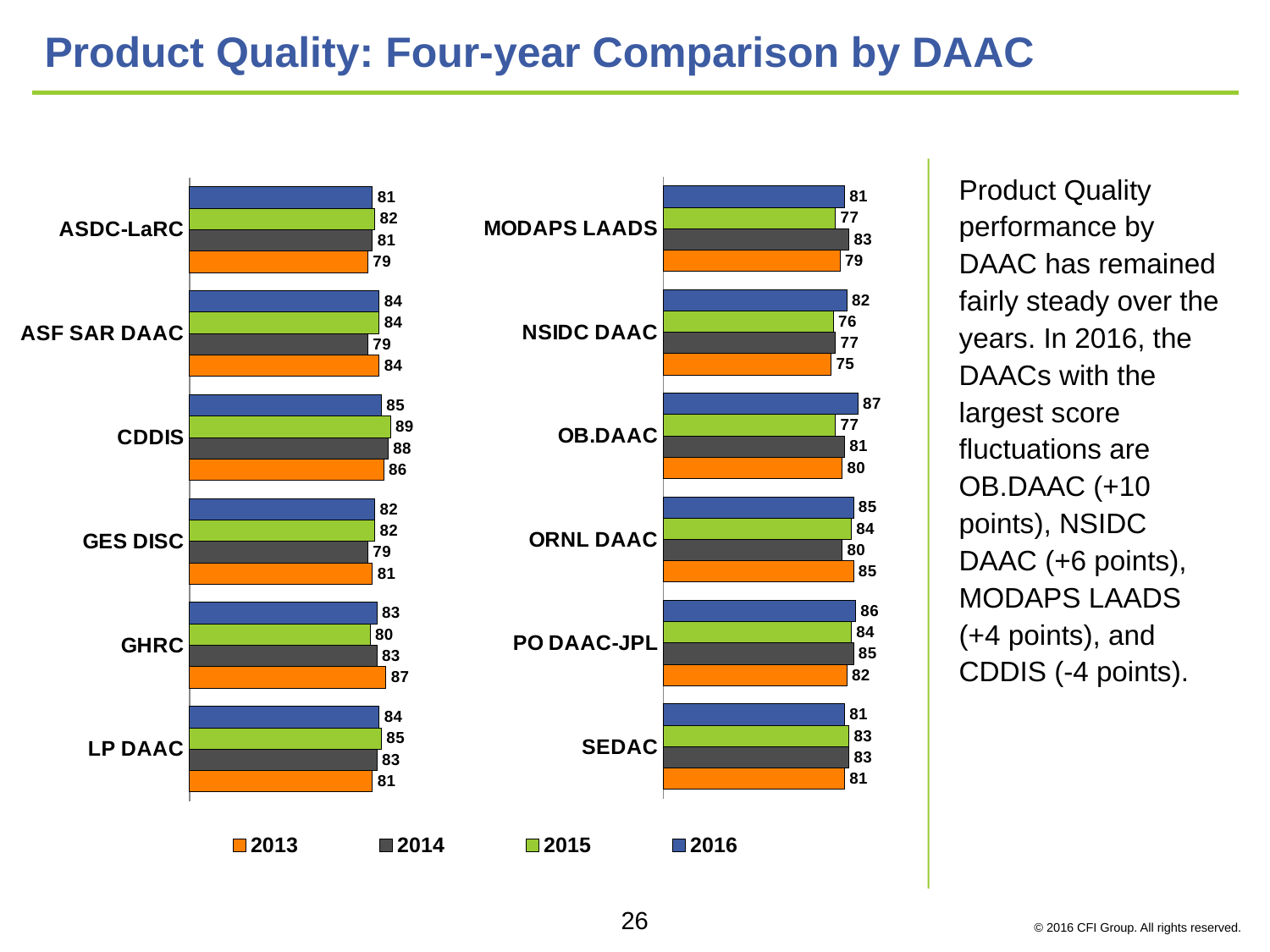
Which colour represents 2013 in the legend? Orange In the right chart, which is larger for MODAPS LAADS: the 2014 value or the 2015 value? 2014 In the left chart, what is the difference between the 2015 and 2014 values for ASF SAR DAAC? 5 How many series does the legend list? 4 In the right chart, which DAAC has the lowest 2015 value? NSIDC DAAC In the left chart, what is the 2015 value for CDDIS? 89 In the right chart, which DAAC has the highest 2016 value? OB.DAAC In the left chart, what is the 2013 value for GHRC? 87 In the right chart, what is the difference between the 2016 and 2013 values for OB.DAAC? 7 What kind of chart is used on this slide? Bar chart In the right chart, what is the 2013 value for NSIDC DAAC? 75 How many DAACs are shown in the left chart? 6